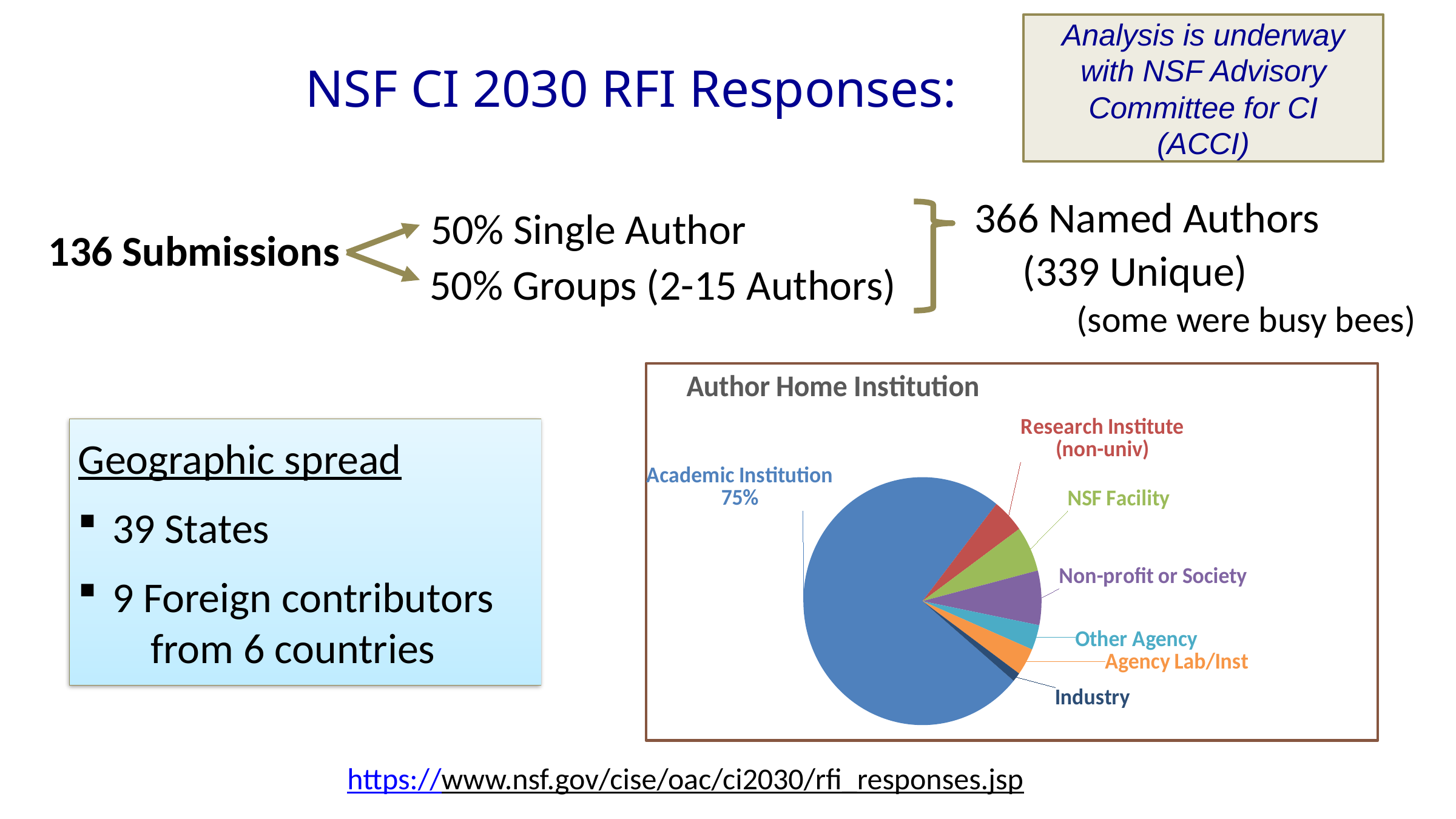
What colour is the Academic Institution slice in the pie chart? blue What kind of chart is shown on the slide? pie chart How many categories does the Author Home Institution pie chart show? 7 What share of the Author Home Institution pie is Academic Institution? 75% Which category has the smallest slice in the Author Home Institution pie chart? Industry What is the title of the pie chart? Author Home Institution In the Author Home Institution pie chart, which is larger: Non-profit or Society or Other Agency? Non-profit or Society Which category has the largest slice in the Author Home Institution pie chart? Academic Institution In the Author Home Institution pie chart, which is larger: Academic Institution or Non-profit or Society? Academic Institution What is the value printed for Academic Institution in the pie chart? 75% In the Author Home Institution pie chart, which is larger: NSF Facility or Industry? NSF Facility